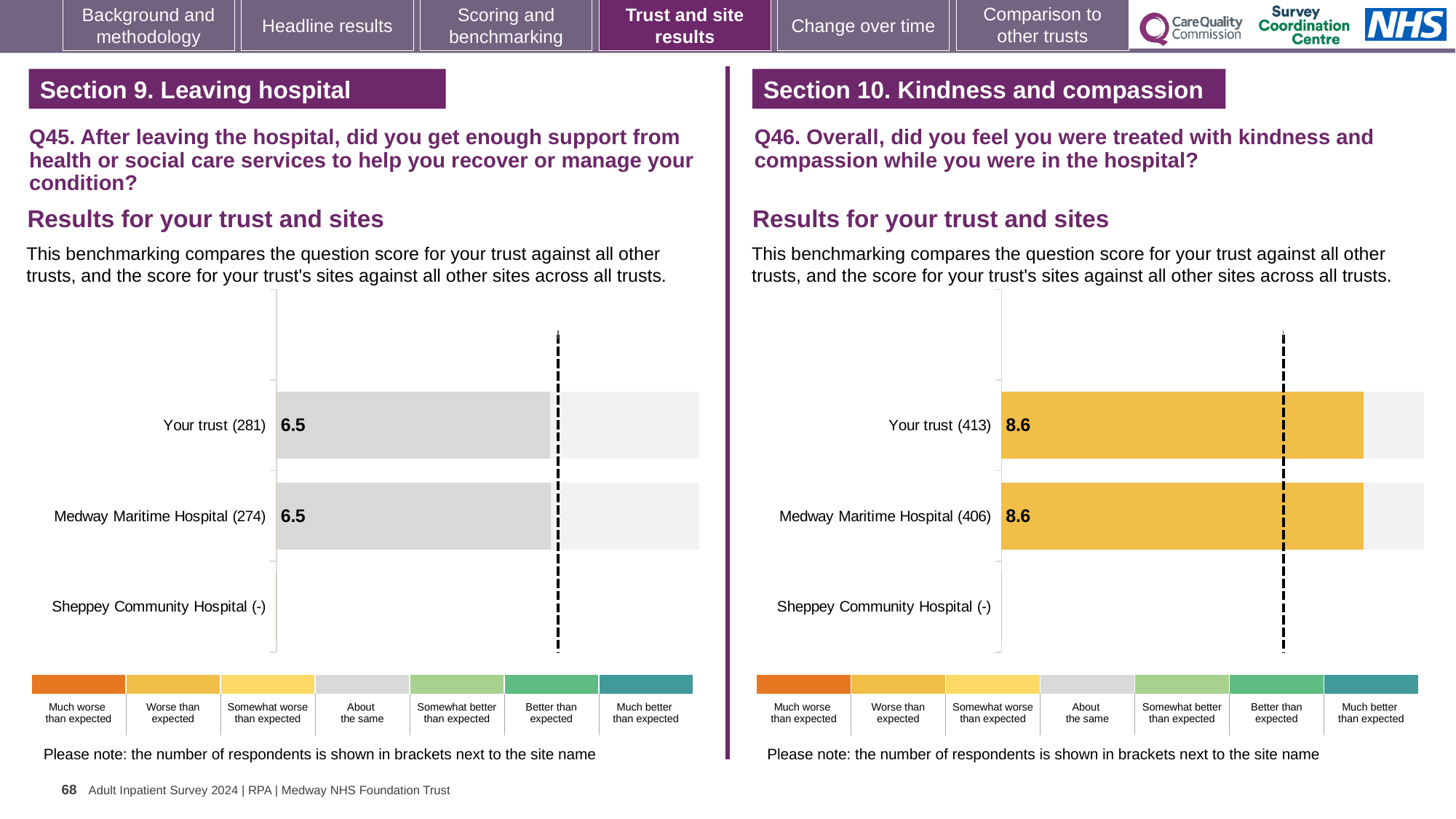
In the Q45 chart on the left, what is the score for Medway Maritime Hospital? 6.5 What is the difference between the Your trust score in the Q46 chart on the right and the Your trust score in the Q45 chart on the left? 2.1 In the Q45 chart on the left, how many respondents are shown in brackets for Your trust? 281 In the Q46 chart on the right, what is the score for Medway Maritime Hospital? 8.6 Which is larger: the Medway Maritime Hospital score in the Q45 chart on the left or in the Q46 chart on the right? Q46 chart on the right In the Q46 chart on the right, what is the score for Your trust? 8.6 In the Q45 chart on the left, how many categories are listed on the vertical axis? 3 What kind of chart is the Q46 chart on the right? Bar chart In the Q45 chart on the left, which benchmark category does the grey colour of the bars correspond to in the legend? About the same In the Q45 chart on the left, what is the score for Your trust? 6.5 In the Q46 chart on the right, how many respondents are shown in brackets for Medway Maritime Hospital? 406 In the Q46 chart on the right, how many categories are listed on the vertical axis? 3